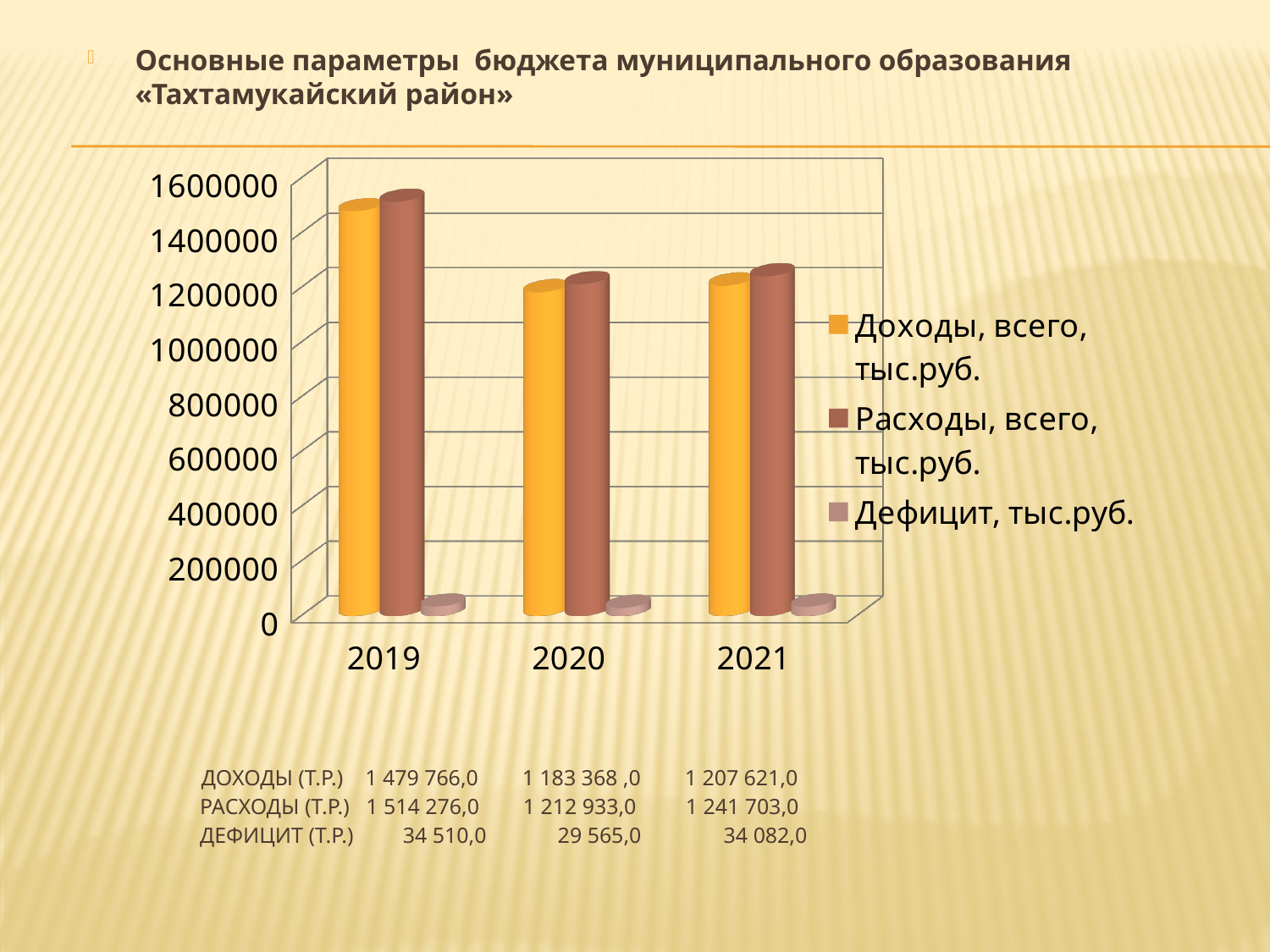
What is the value of Дефицит (deficit) for 2020 according to the slide? 29 565,0 Is the value for Доходы in 2020 greater or less than 1200000? less What is the value of Доходы (income) for 2019 according to the slide? 1 479 766,0 Which is larger in 2020, Доходы or Расходы? Расходы Does Доходы rise or fall from 2019 to 2020? fall What is the value of Расходы (expenditure) for 2021 according to the slide? 1 241 703,0 How many years are shown on the x axis of the chart? 3 What is the difference between Расходы and Доходы in 2019? 34 510,0 How many series does the chart legend list? 3 In which year is Доходы (income) the highest? 2019 In which year is Расходы (expenditure) the lowest? 2020 What type of chart is shown on the slide? bar chart